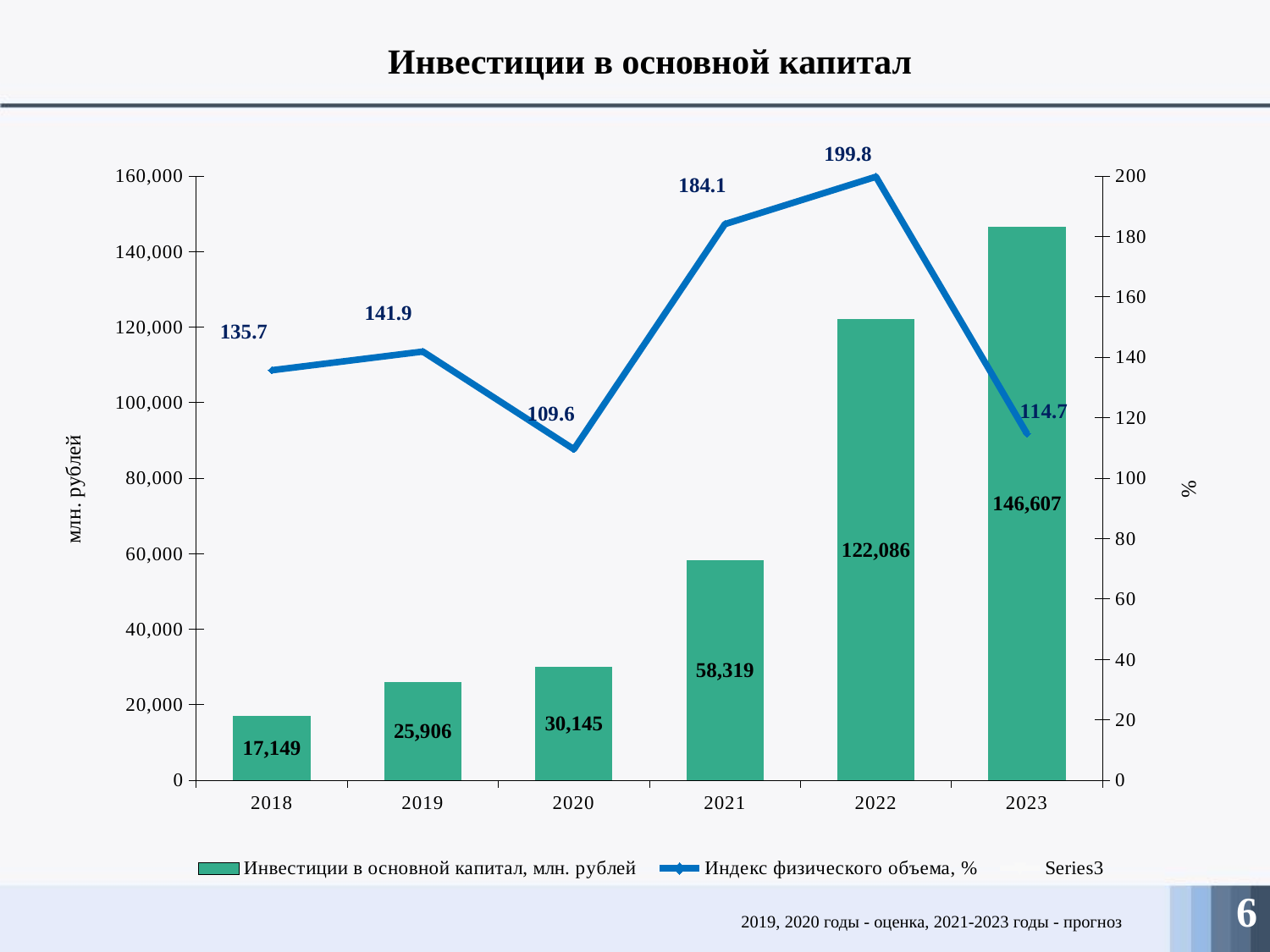
What is the value of the physical volume index (Индекс физического объема, %) for 2022? 199.8 What is the difference between investments in fixed capital in 2023 and 2022? 24,521 Which year has the highest value of investments in fixed capital? 2023 Which year has the lowest value of the physical volume index? 2020 What is the difference between the physical volume index in 2022 and 2023? 85.1 Do the investments in fixed capital rise or fall from 2018 to 2023? rise What is the value of investments in fixed capital (Инвестиции в основной капитал, млн. рублей) for 2021? 58,319 What is the title of the chart? Инвестиции в основной капитал How many series does the legend list? 3 Which is larger: the physical volume index in 2019 or in 2020? 2019 How many years are shown on the x axis? 6 What is the value of investments in fixed capital for 2018? 17,149